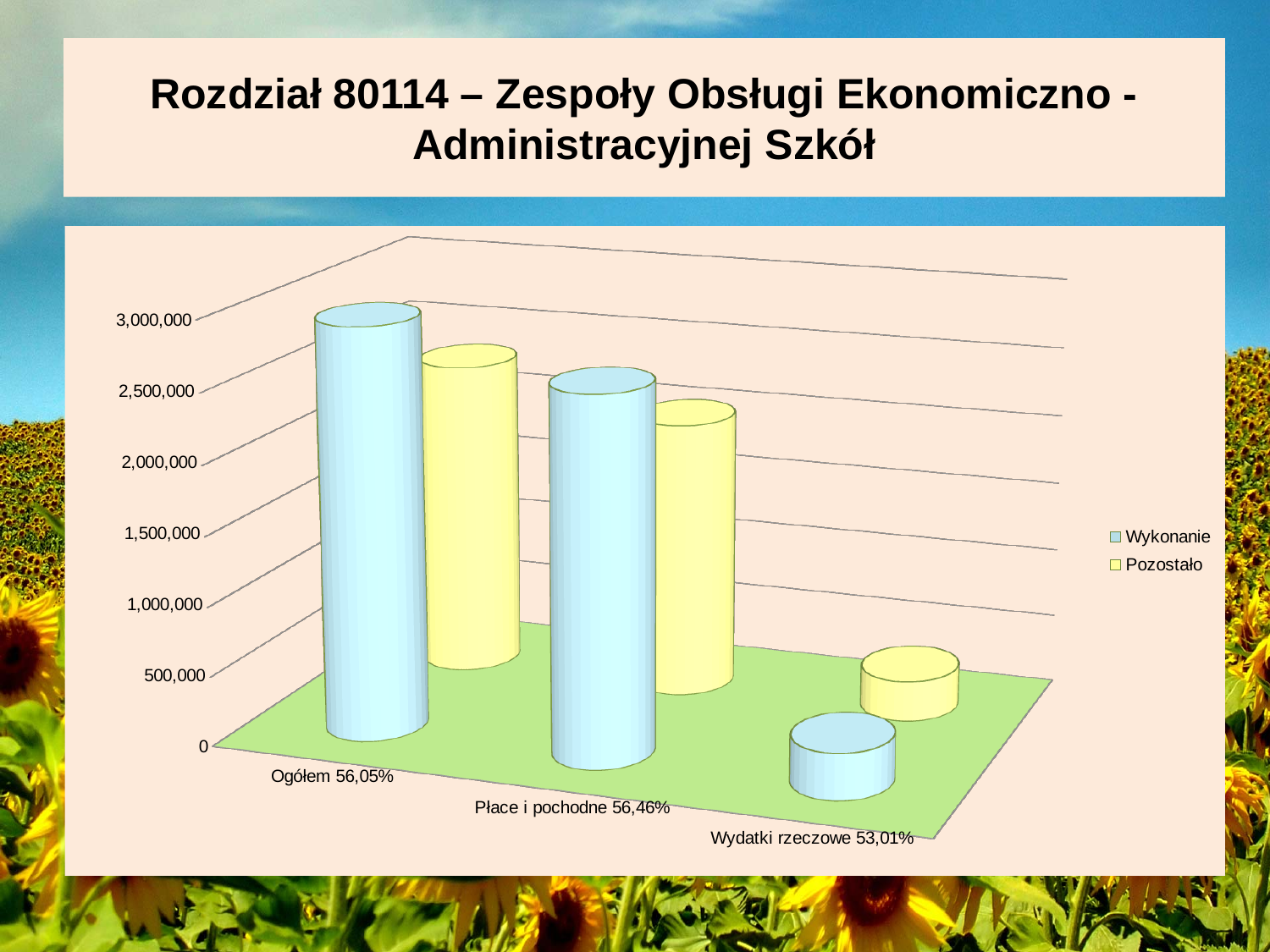
Which is larger: the Wykonanie value for Ogółem or the Wykonanie value for Wydatki rzeczowe? Ogółem How many categories are shown on the x axis? 3 Which series is shown in yellow? Pozostało Is the Wykonanie value for Płace i pochodne greater or less than 2,000,000? greater Which category has the lowest Wykonanie value? Wydatki rzeczowe 53,01% What kind of chart is shown on the slide? bar chart Is the Wykonanie value for Ogółem greater or less than 2,500,000? greater Is the Wykonanie value for Wydatki rzeczowe greater or less than 500,000? less Which category has the highest Wykonanie value? Ogółem 56,05% Which category has the lowest Pozostało value? Wydatki rzeczowe 53,01% How many series does the legend list? 2 What is the title of the slide containing the chart? Rozdział 80114 – Zespoły Obsługi Ekonomiczno - Administracyjnej Szkół